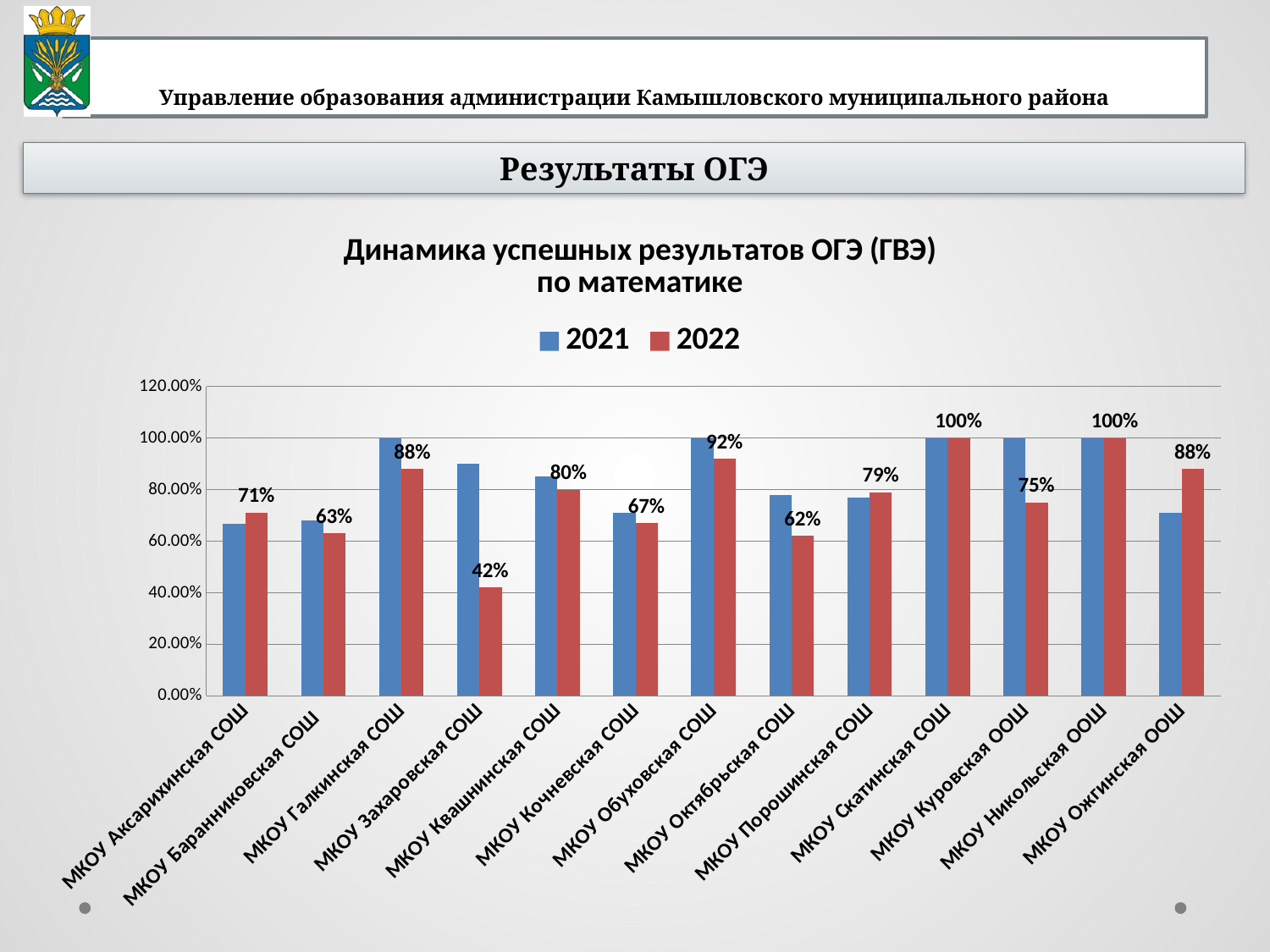
What is the 2022 value for МКОУ Обуховская СОШ? 92% What is the difference between the 2022 values for МКОУ Галкинская СОШ and МКОУ Захаровская СОШ? 46 percentage points How many schools are shown on the x axis? 13 How many schools have a 2022 value of 100%? 2 What is the 2022 value for МКОУ Куровская ООШ? 75% Which has the larger 2022 value, МКОУ Куровская ООШ or МКОУ Порошинская СОШ? МКОУ Порошинская СОШ What is the 2022 value for МКОУ Захаровская СОШ? 42% Is the 2021 value for МКОУ Захаровская СОШ greater or less than 80.00%? greater Which school has the lowest 2022 value? МКОУ Захаровская СОШ How many series does the legend list? 2 For МКОУ Захаровская СОШ, which year has the larger value, 2021 or 2022? 2021 Is the 2021 value for МКОУ Аксарихинская СОШ greater or less than 80.00%? less